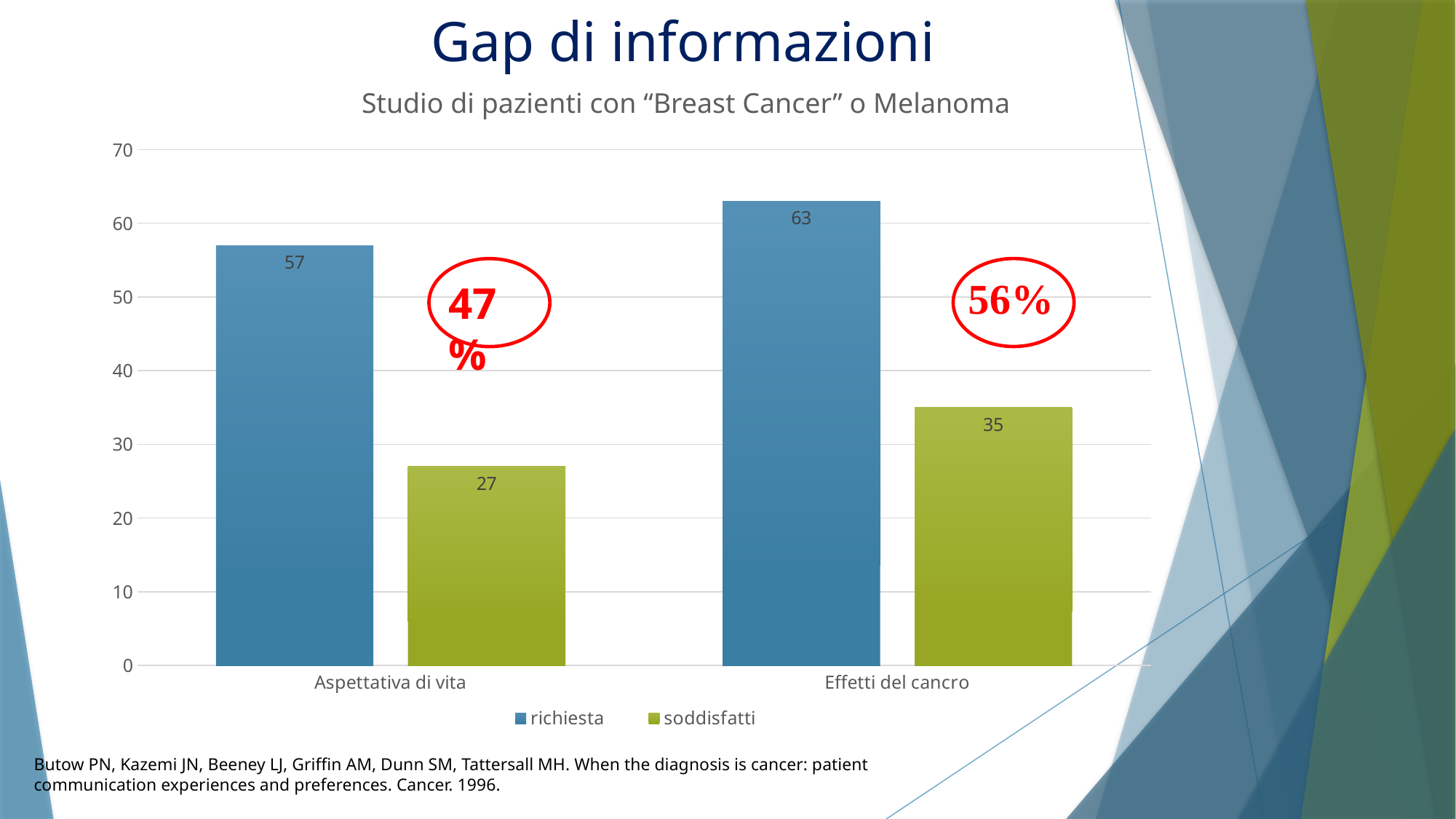
What is the value of "soddisfatti" for "Effetti del cancro"? 35 Which category has the highest "richiesta" value? Effetti del cancro Which category has the lowest "soddisfatti" value? Aspettativa di vita What kind of chart is shown on the slide? Bar chart What is the difference between "richiesta" and "soddisfatti" for "Aspettativa di vita"? 30 How many series does the legend list? 2 Which is larger: "richiesta" for "Aspettativa di vita" or "richiesta" for "Effetti del cancro"? Effetti del cancro What is the value of "soddisfatti" for "Aspettativa di vita"? 27 What is the value of "richiesta" for "Aspettativa di vita"? 57 How many categories are shown on the x axis? 2 What is the difference between "richiesta" and "soddisfatti" for "Effetti del cancro"? 28